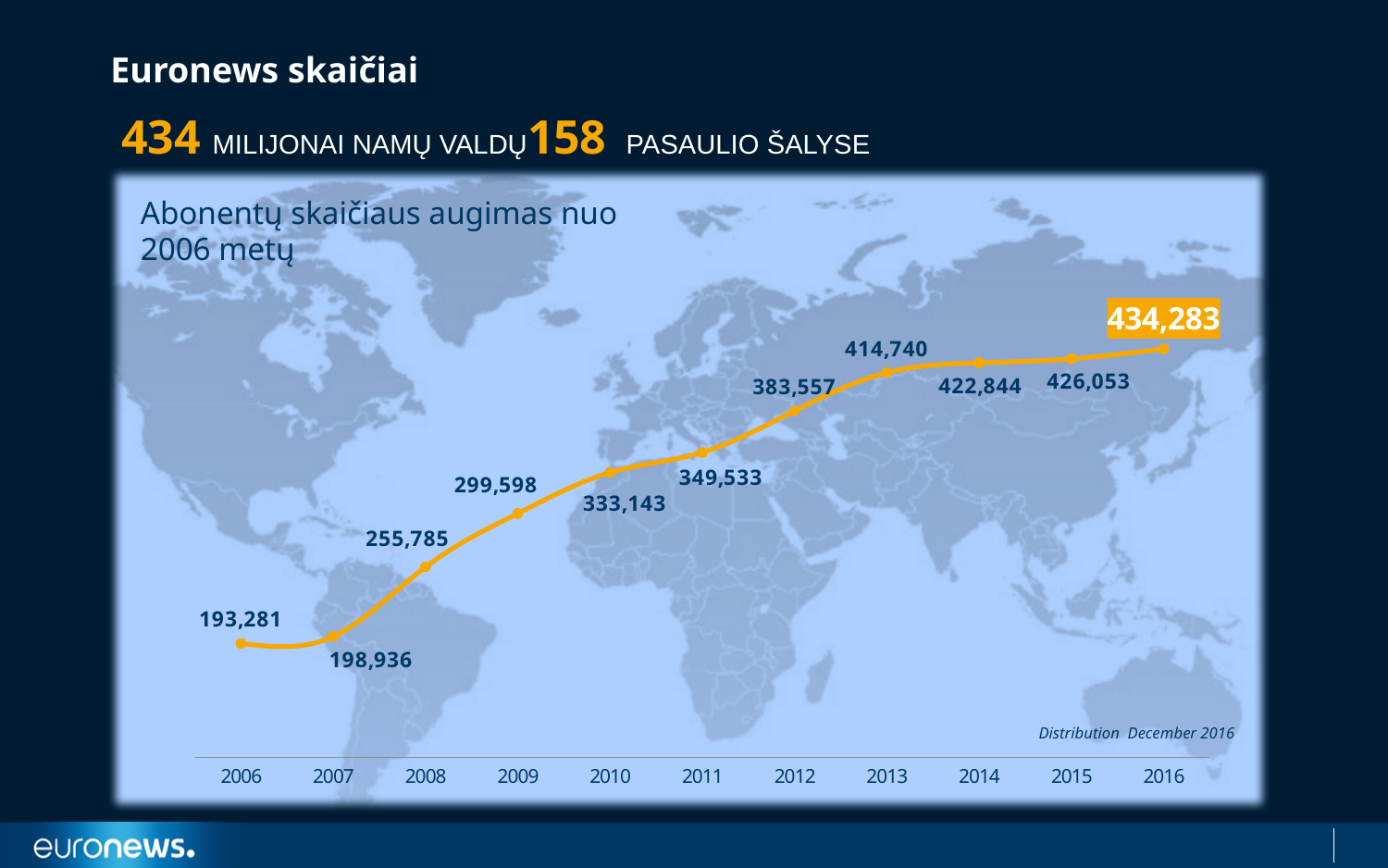
What is the difference between the values for 2008 and 2007? 56,849 Which is larger, the value for 2011 or the value for 2012? 2012 What kind of chart is shown? line chart What is the value for 2016? 434,283 How many years are plotted on the x axis? 11 What is the value for 2010? 333,143 Which year has the highest value? 2016 Do the values rise or fall from 2006 to 2016? rise What is the difference between the values for 2016 and 2006? 241,002 Which year has the lowest value? 2006 What is the value for 2013? 414,740 What is the value for 2006? 193,281